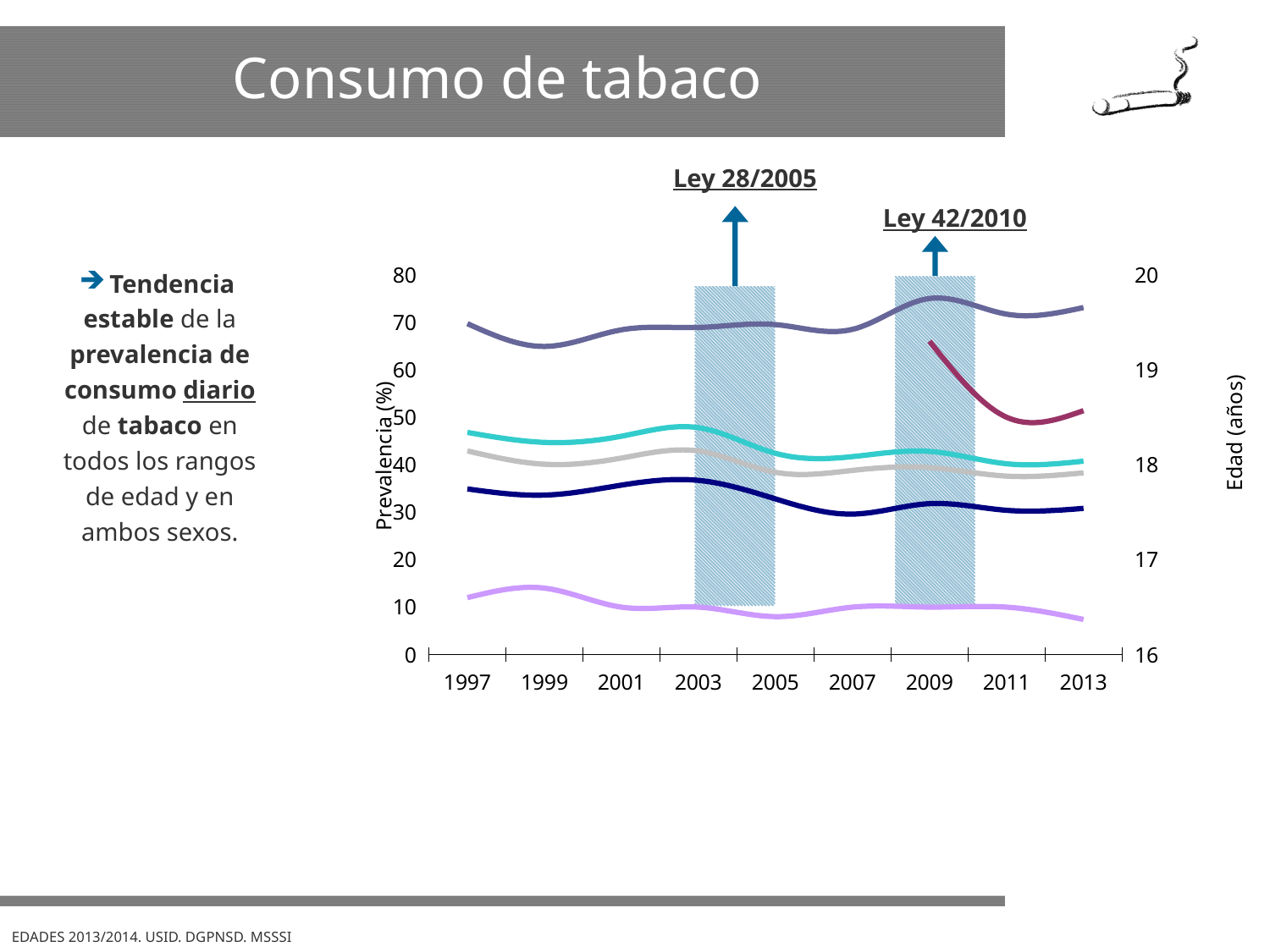
Is the value of the topmost line in 1997 greater or less than 60? greater How many lines are plotted on the chart? 6 Is the value of the lowest line in 2013 greater or less than 20? less Does the dark red line rise or fall between 2009 and 2013? fall Is the value of the topmost line in 2013 greater or less than 60? greater How many years are labelled on the x axis of the chart? 9 What is the title of the right vertical axis of the chart? Edad (años) What is the title of the left vertical axis of the chart? Prevalencia (%) What kind of chart is shown on the slide? line chart